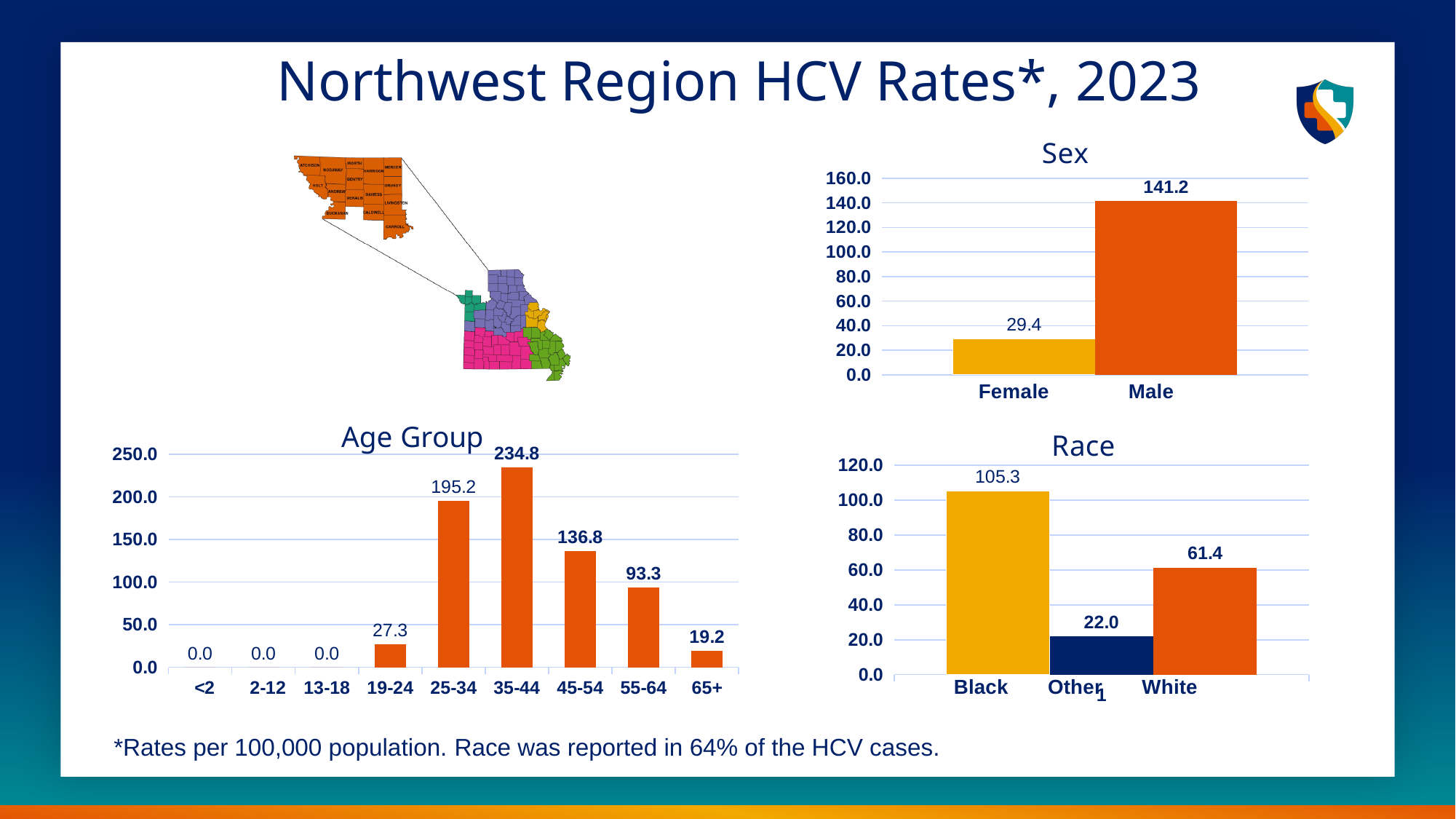
In the Age Group chart, which is larger, the rate for 45-54 or the rate for 55-64? 45-54 In the Age Group chart, what is the difference between the 35-44 and 25-34 rates? 39.6 In the Sex chart, what is the HCV rate for Female? 29.4 In the Race chart, what is the rate for White? 61.4 In the Age Group chart, which age group has the highest rate? 35-44 In the Sex chart, what is the difference between the Male and Female rates? 111.8 In the Race chart, which category has the lowest rate? Other In the Age Group chart, what is the rate for the 65+ age group? 19.2 In the Sex chart, what is the HCV rate for Male? 141.2 In the Age Group chart, what is the rate for the 25-34 age group? 195.2 What kind of chart is the Race chart? Bar chart In the Age Group chart, how many age group categories are shown on the x axis? 9